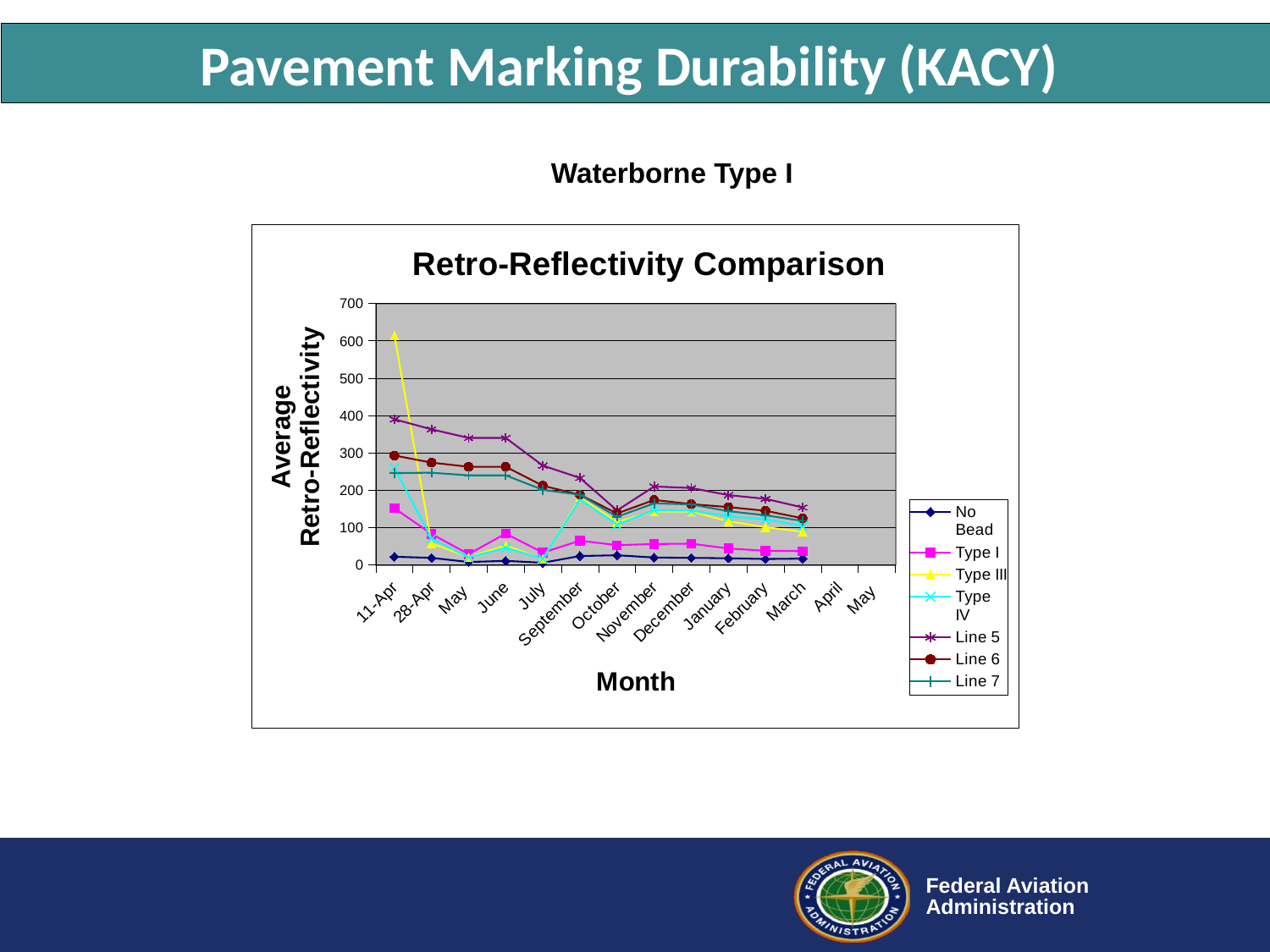
Do the values for Line 5 generally rise or fall from 11-Apr to March? Fall Which series has the highest value in March? Line 5 How many month labels are shown along the x axis? 14 Which series has the lowest values across the chart? No Bead Is the value for Type III at 11-Apr greater or less than 500? greater Which is larger at 11-Apr, Line 5 or Line 6? Line 5 Is the value for No Bead in March greater or less than 100? less What is the title of the chart? Retro-Reflectivity Comparison How many series does the legend list? 7 Which series has the highest value at 11-Apr? Type III What kind of chart is shown on the slide? Line chart Is the value for Line 5 at 11-Apr greater or less than 300? greater